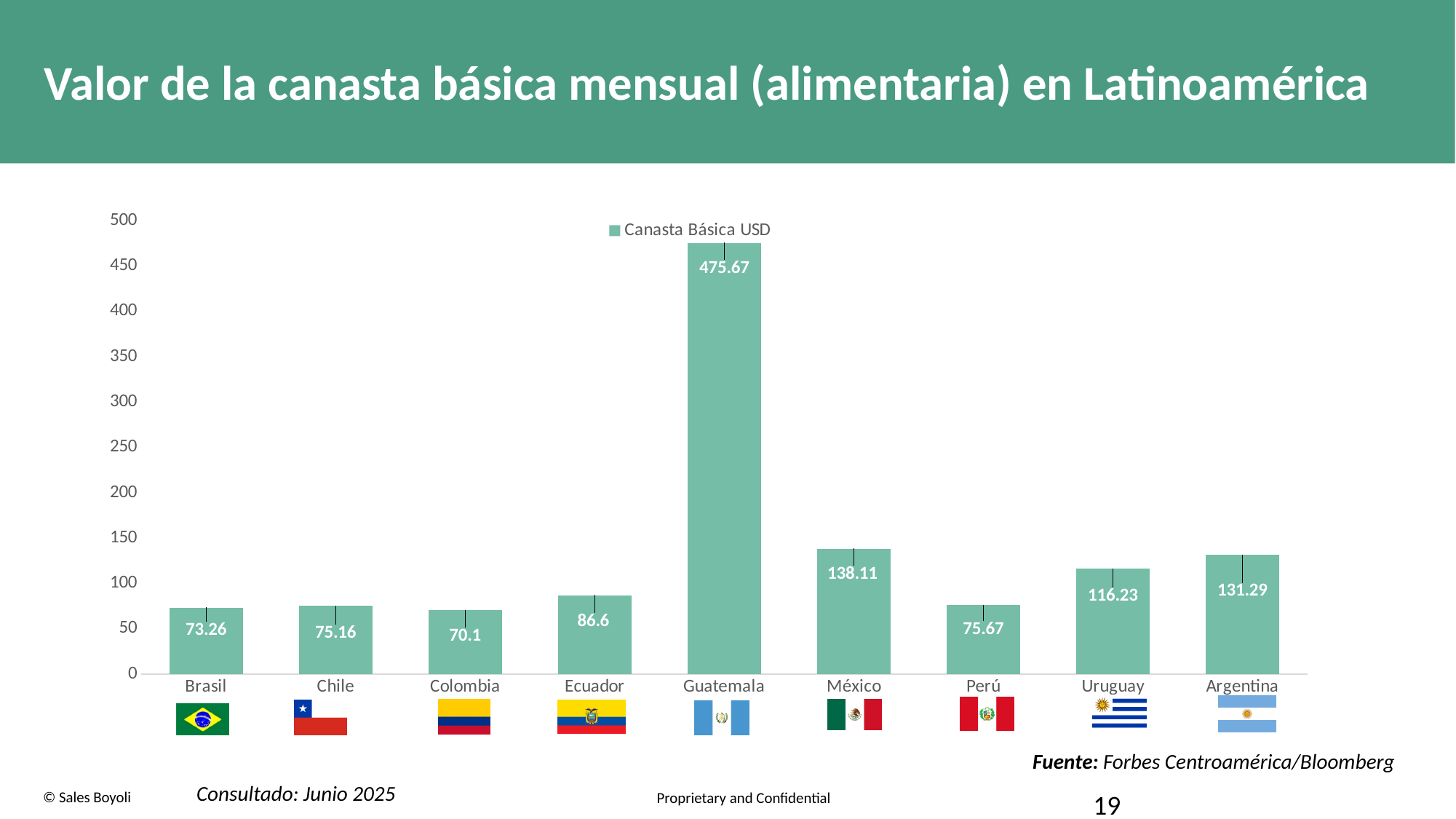
Which country has the lowest value? Colombia What is the value for Guatemala? 475.67 What is the value for Colombia? 70.1 How many countries are shown on the x axis? 9 Which country has the highest value? Guatemala Is the value for Ecuador greater or less than 100? less What is the difference between the values for México and Perú? 62.44 What is the legend entry for the series? Canasta Básica USD Which is larger, the value for Argentina or the value for Uruguay? Argentina How many series does the legend list? 1 What kind of chart is shown? bar chart What is the value for Uruguay? 116.23